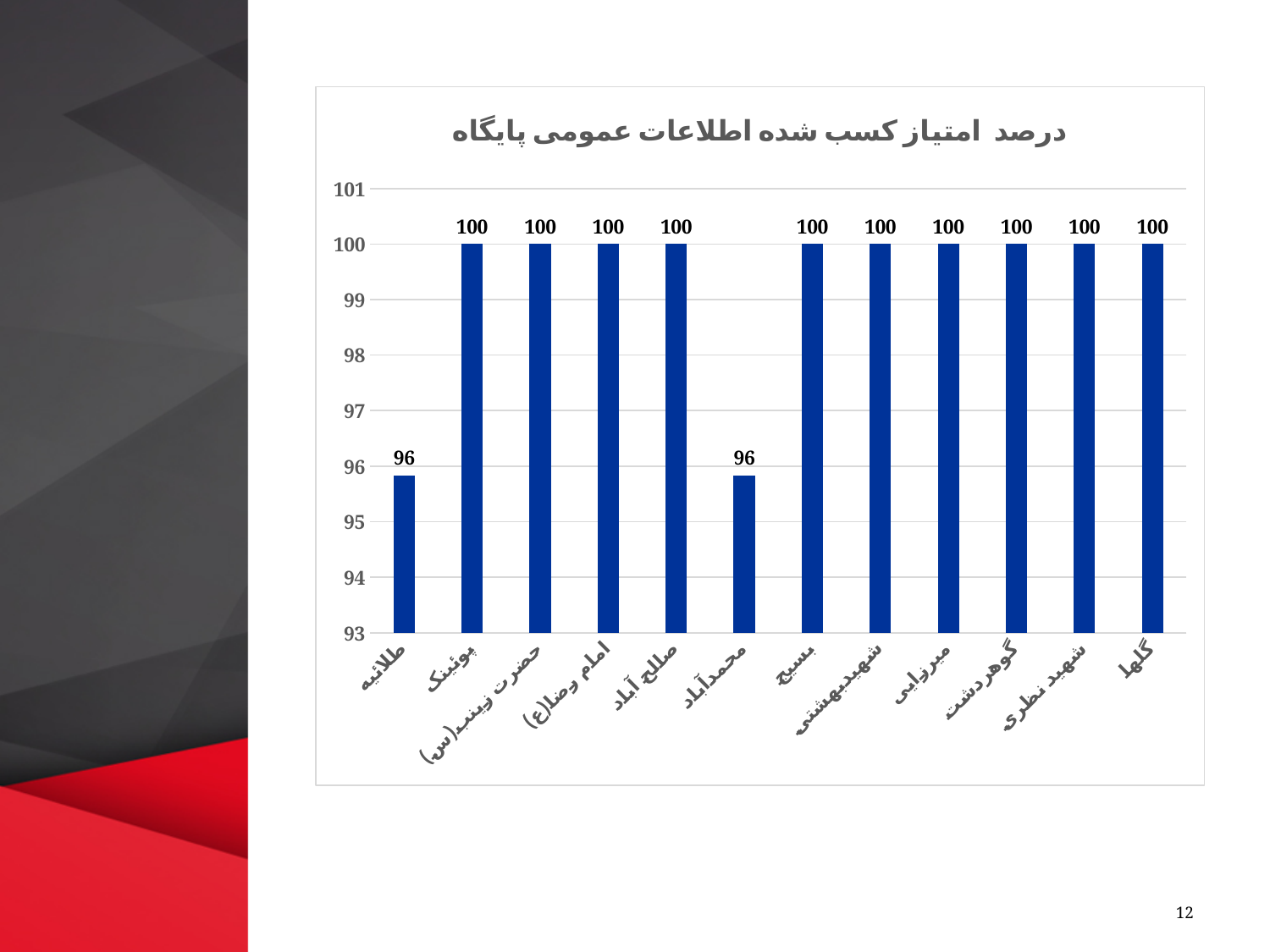
What is the value for محمدآباد? 96 Which categories have the lowest value? طلائیه and محمدآباد What is the value for بسیج? 100 What is the value for طلائیه? 96 Which is larger, the value for صالح آباد or the value for محمدآباد? صالح آباد What kind of chart is shown on the slide? bar chart How many categories are shown on the x axis? 12 What is the value for گلها? 100 What is the difference between the values for پوئینک and طلائیه? 4 Is the value for طلائیه greater or less than 98? less How many categories have a value of 100? 10 What is the title of the chart? درصد امتیاز کسب شده اطلاعات عمومی پایگاه